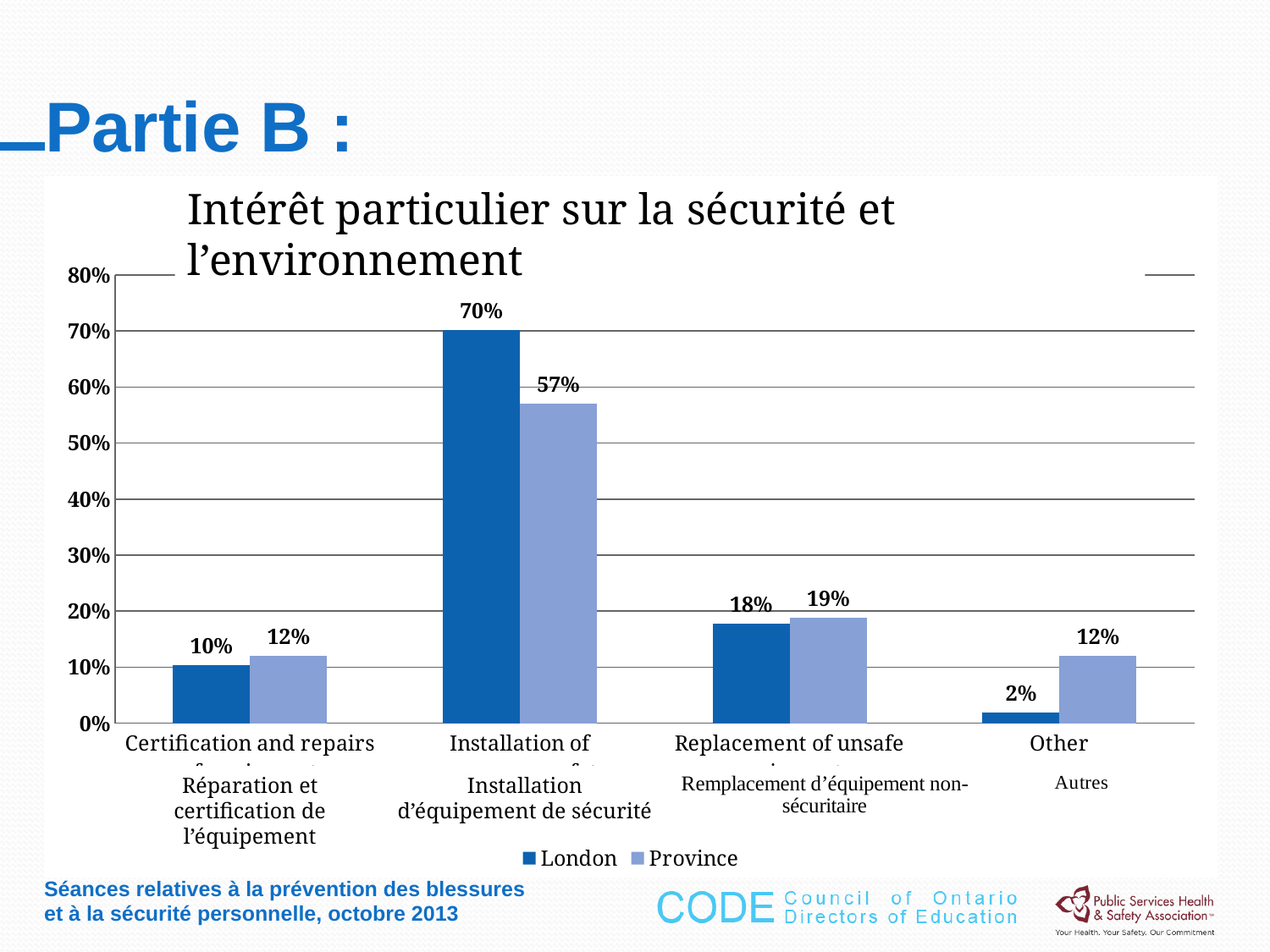
What is the London value for Replacement of unsafe equipment? 18% How many series does the legend list? 2 What is the Province value for Certification and repairs? 12% What kind of chart is shown on the slide? Bar chart What is the Province value for Other? 12% Which category has the highest London value? Installation of safety equipment What is the London value for Installation of safety equipment? 70% Which category has the lowest London value? Other What are the two series named in the legend? London and Province How many categories are shown on the x axis? 4 For Other, which is larger, the London value or the Province value? Province What is the difference between the London and Province values for Installation of safety equipment? 13%